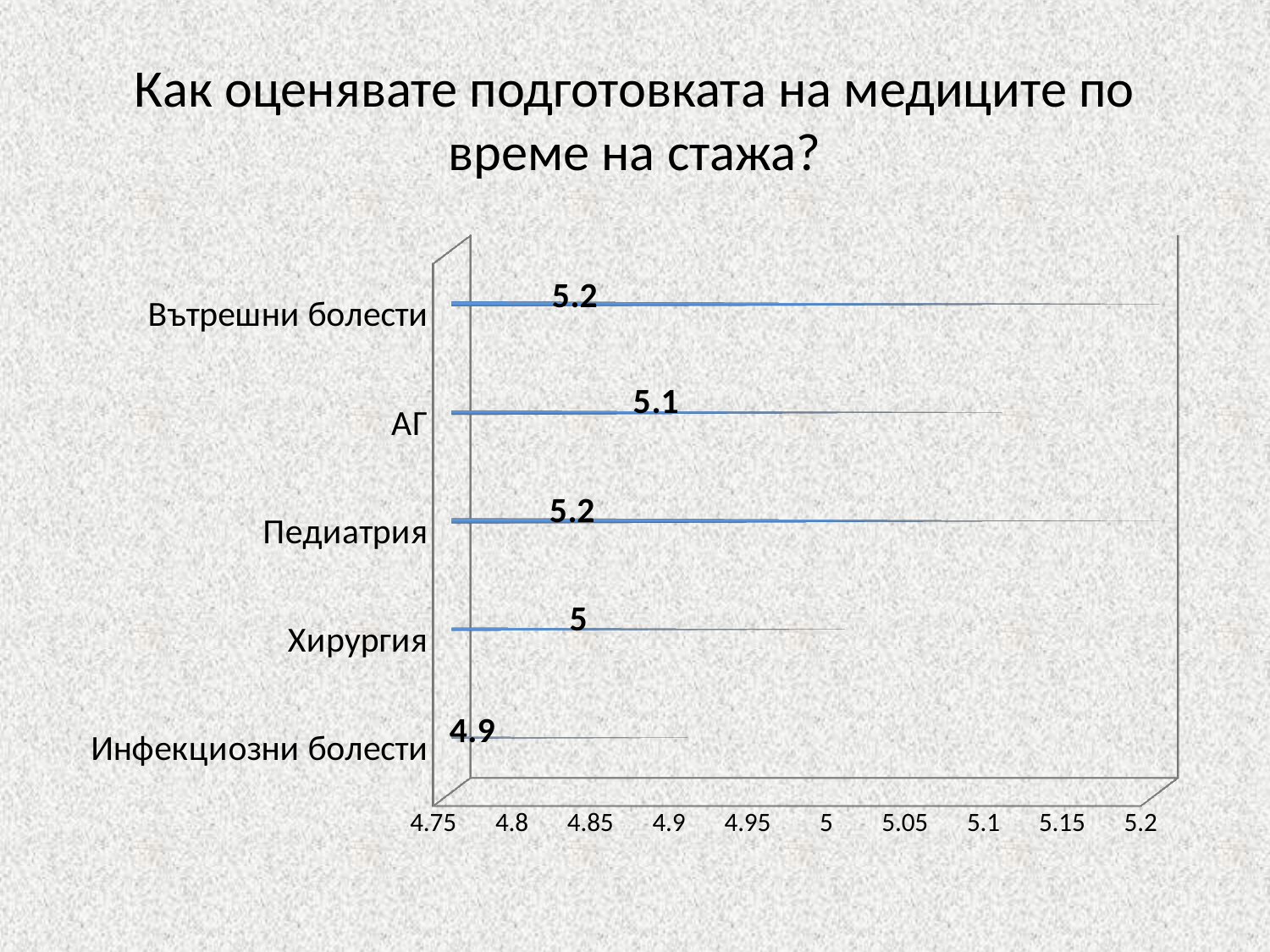
Which is larger, the value for АГ or the value for Хирургия? АГ What is the value for АГ? 5.1 What is the value for Вътрешни болести? 5.2 Which category has the lowest value? Инфекциозни болести What is the title of the slide? Как оценявате подготовката на медиците по време на стажа? Is the value for Инфекциозни болести greater or less than 5? less What is the value for Инфекциозни болести? 4.9 What is the difference between the values for Педиатрия and Инфекциозни болести? 0.3 What kind of chart is shown on the slide? bar chart What is the difference between the values for АГ and Хирургия? 0.1 What is the value for Хирургия? 5 How many categories are shown in the chart? 5